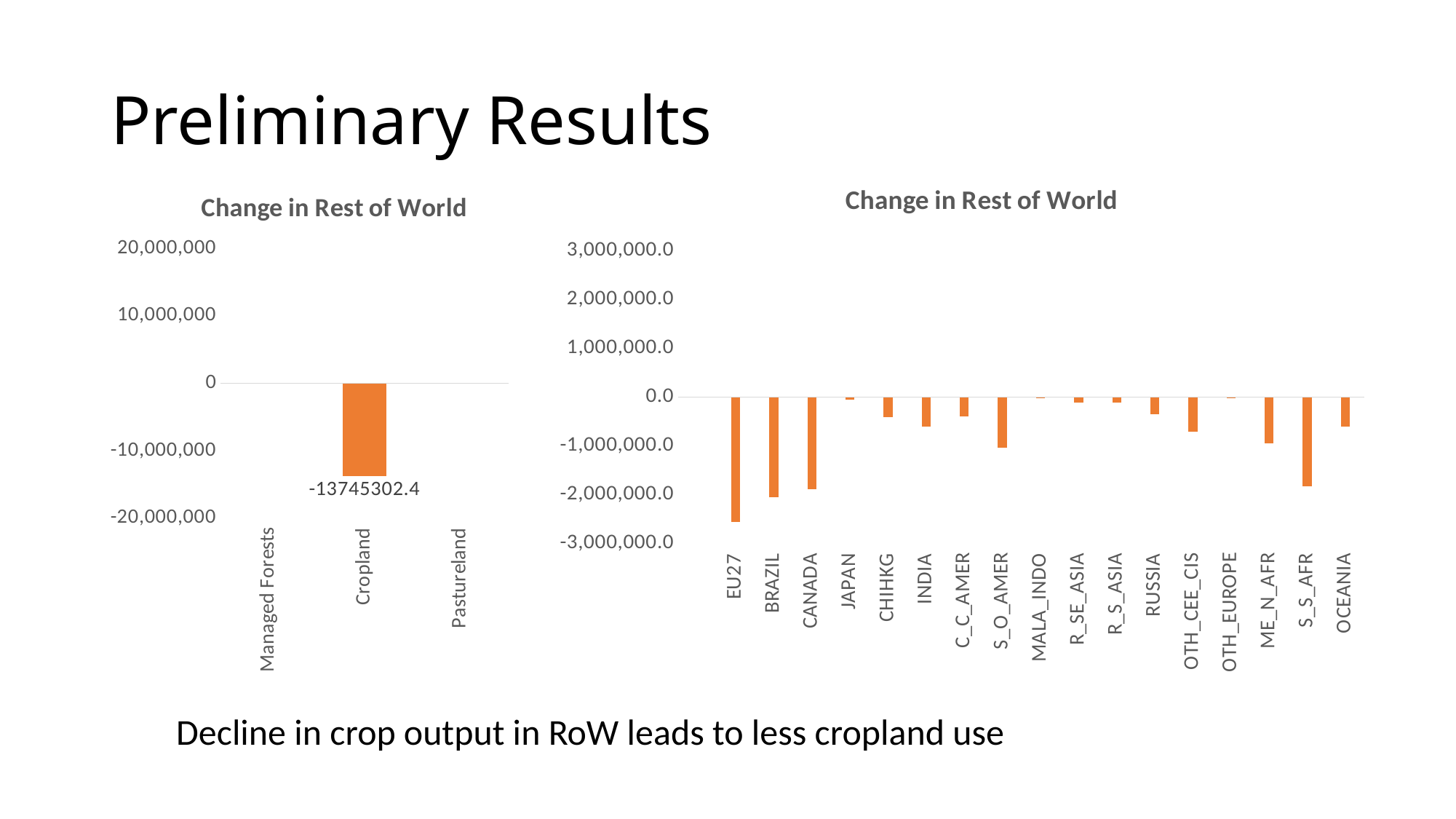
On the right chart, how many regions are shown on the x axis? 17 On the left chart, which category has the lowest value? Cropland On the right chart, which region shows the larger decline, S_S_AFR or INDIA? S_S_AFR What is the title of the right chart? Change in Rest of World On the right chart, which region shows the larger decline, EU27 or OCEANIA? EU27 On the right chart, is the value for EU27 greater or less than -2,000,000.0? less On the right chart, is the value for S_S_AFR greater or less than -1,000,000.0? less What kind of chart is the left chart? bar chart On the right chart, which region has the lowest (most negative) value? EU27 On the left chart, how many categories are shown on the x axis? 3 On the left chart, what is the value for Cropland? -13745302.4 On the right chart, is the value for OCEANIA greater or less than -1,000,000.0? greater